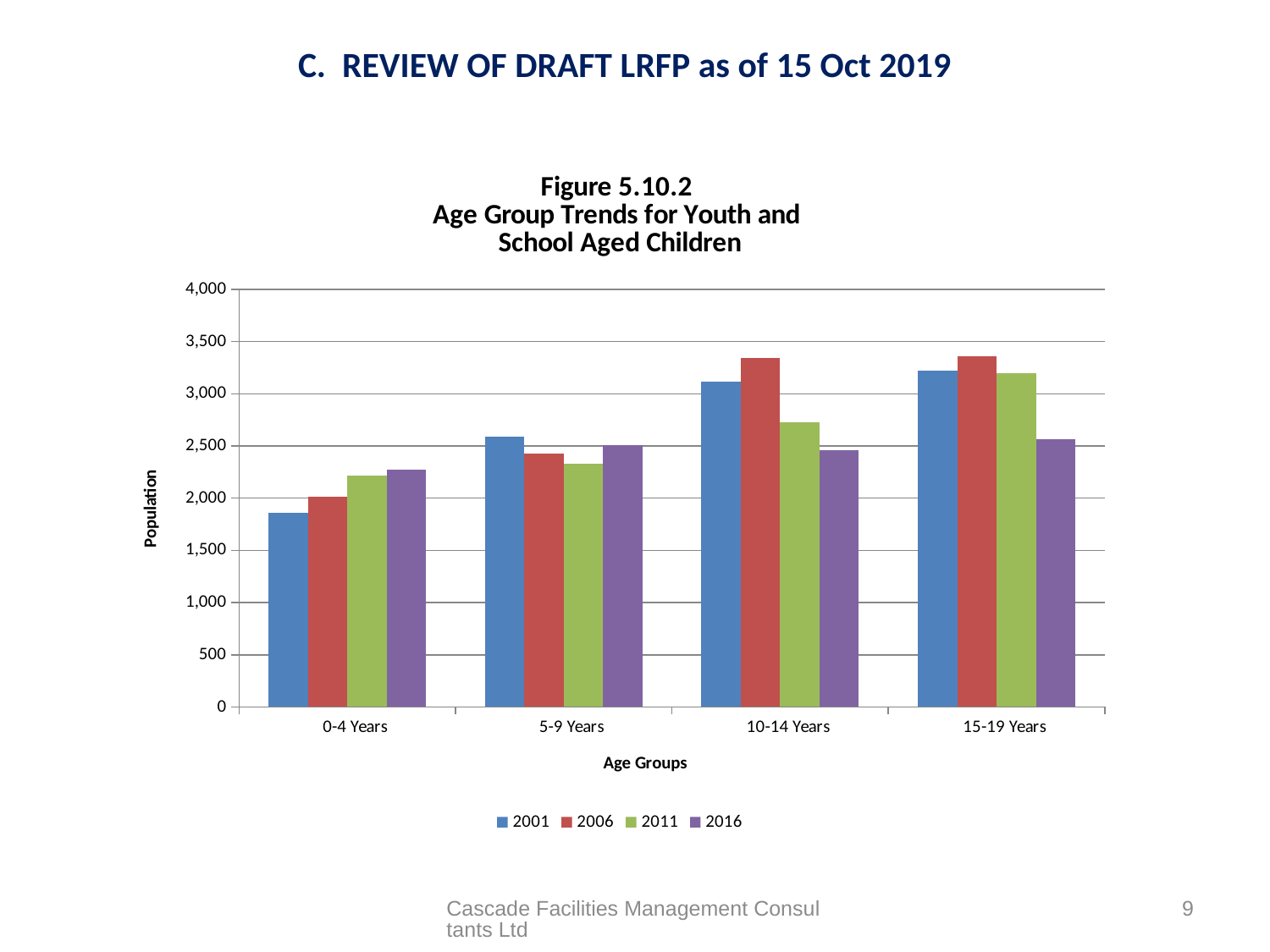
For the 2001 series, which age group has the lowest population? 0-4 Years What kind of chart is shown in Figure 5.10.2? Bar chart In the 10-14 Years group, which is larger: the 2001 value or the 2011 value? 2001 Is the 2006 value for 10-14 Years greater or less than 3,000? greater Is the 2011 value for 5-9 Years greater or less than 2,500? less How many age groups are shown on the x axis? 4 Within the 10-14 Years group, which year has the highest population? 2006 Within the 15-19 Years group, which year has the lowest population? 2016 How many series does the legend list? 4 Is the 2001 value for 15-19 Years greater or less than 3,000? greater Does the 2001 series rise or fall as the age groups move from 0-4 Years to 15-19 Years? Rise